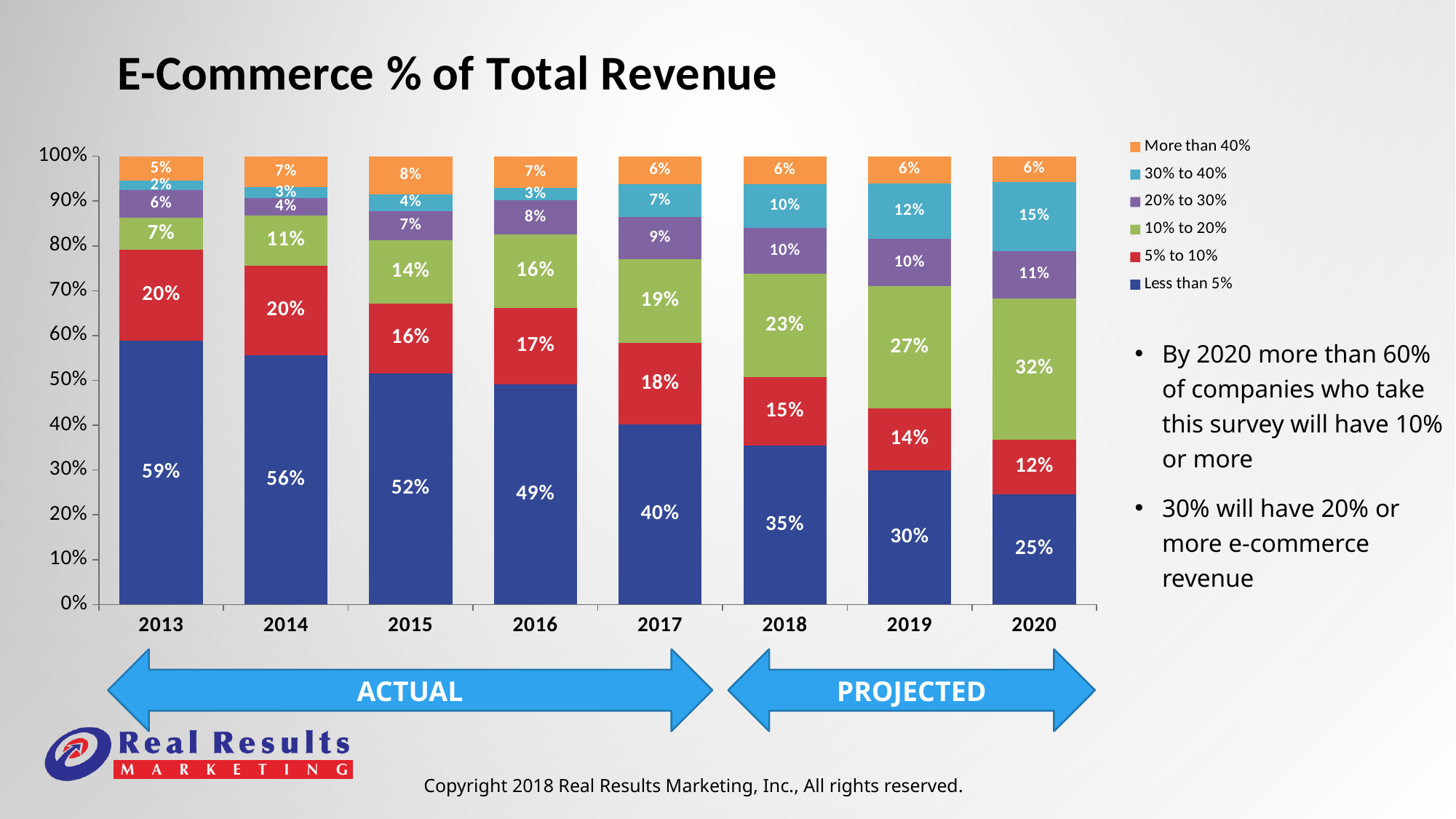
What is the value for 'Less than 5%' in 2013? 59% How many series does the legend list? 6 Which year has the lowest value for '10% to 20%'? 2013 Does the 'Less than 5%' value rise or fall from 2013 to 2020? Fall What kind of chart is shown on the slide? Stacked bar chart Which year has the highest value for 'Less than 5%'? 2013 What is the value for '30% to 40%' in 2019? 12% How many years are shown on the x axis? 8 What is the difference between the 'Less than 5%' values for 2013 and 2020? 34% What is the value for '10% to 20%' in 2020? 32% Which is larger: the '10% to 20%' value in 2018 or the '5% to 10%' value in 2018? 10% to 20% What is the value for '5% to 10%' in 2017? 18%